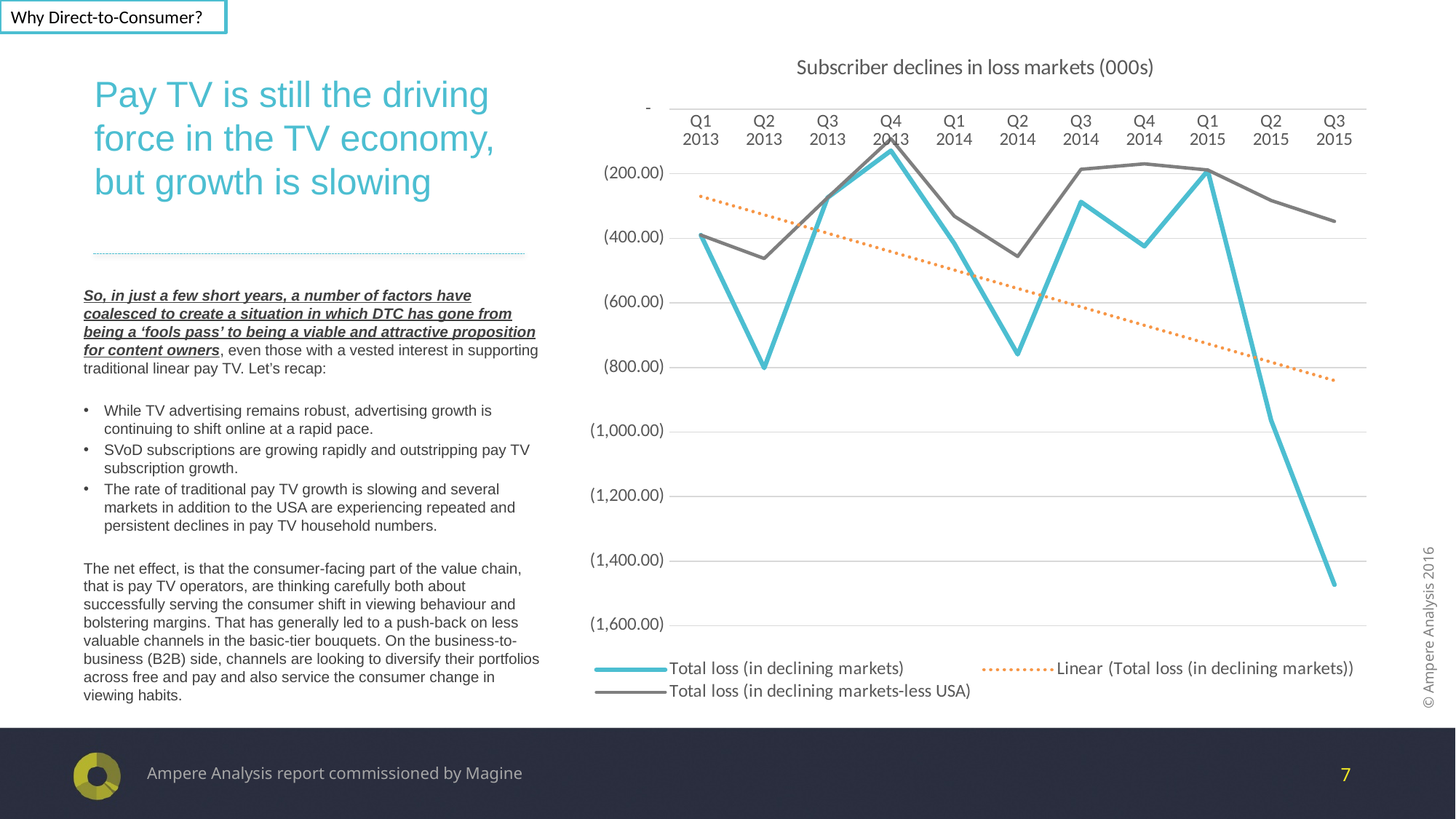
Which quarter has the highest (closest to zero) value for Total loss (in declining markets-less USA)? Q4 2013 Is the Total loss (in declining markets) value for Q3 2015 greater or less than (1,400.00) on the axis? less Which quarter has the highest (closest to zero) value for Total loss (in declining markets)? Q4 2013 Is the Total loss (in declining markets-less USA) value for Q3 2015 greater or less than (600.00) on the axis? greater In Q2 2013, which series has the lower value: Total loss (in declining markets) or Total loss (in declining markets-less USA)? Total loss (in declining markets) How many series does the chart legend list? 3 What is the title of the chart? Subscriber declines in loss markets (000s) What kind of chart is shown on the slide? line chart Is the Total loss (in declining markets) value for Q2 2013 greater or less than (600.00) on the axis? less How many quarters are plotted along the x axis? 11 Which quarter has the lowest value for Total loss (in declining markets)? Q3 2015 Does the Total loss (in declining markets) line rise or fall from Q1 2015 to Q3 2015? fall